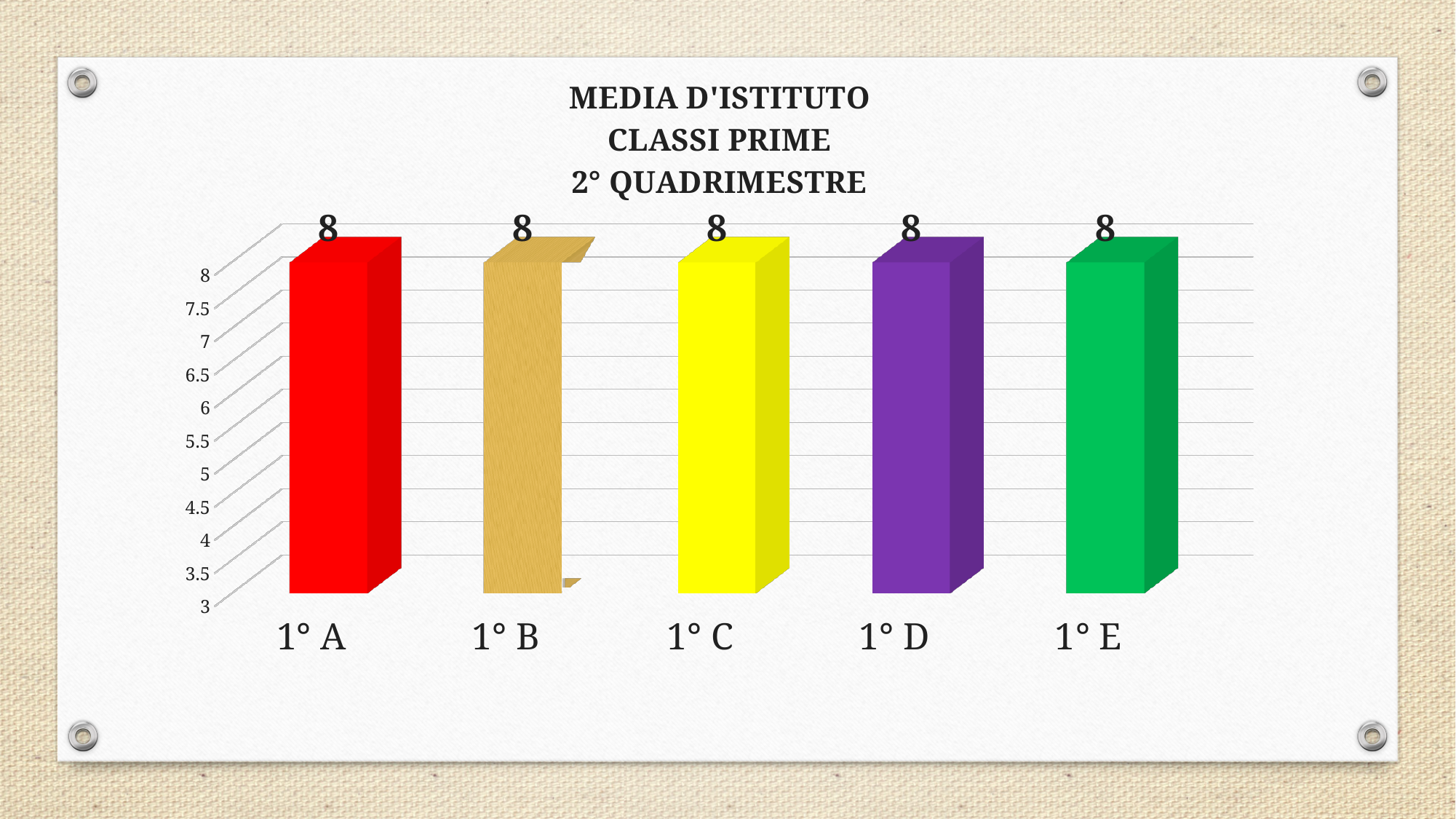
What is the lowest value shown on the vertical axis? 3 Is the value for 1° B greater or less than 5? greater What is the value shown for 1° D? 8 How many classes are shown on the x axis? 5 What is the difference between the values for 1° A and 1° B? 0 What kind of chart is shown on the slide? bar chart Do the values rise, fall, or stay the same from 1° A to 1° E? stay the same What is the value shown for 1° E? 8 What is the value shown for 1° A? 8 What is the title of the chart? MEDIA D'ISTITUTO CLASSI PRIME 2° QUADRIMESTRE What is the value shown for 1° C? 8